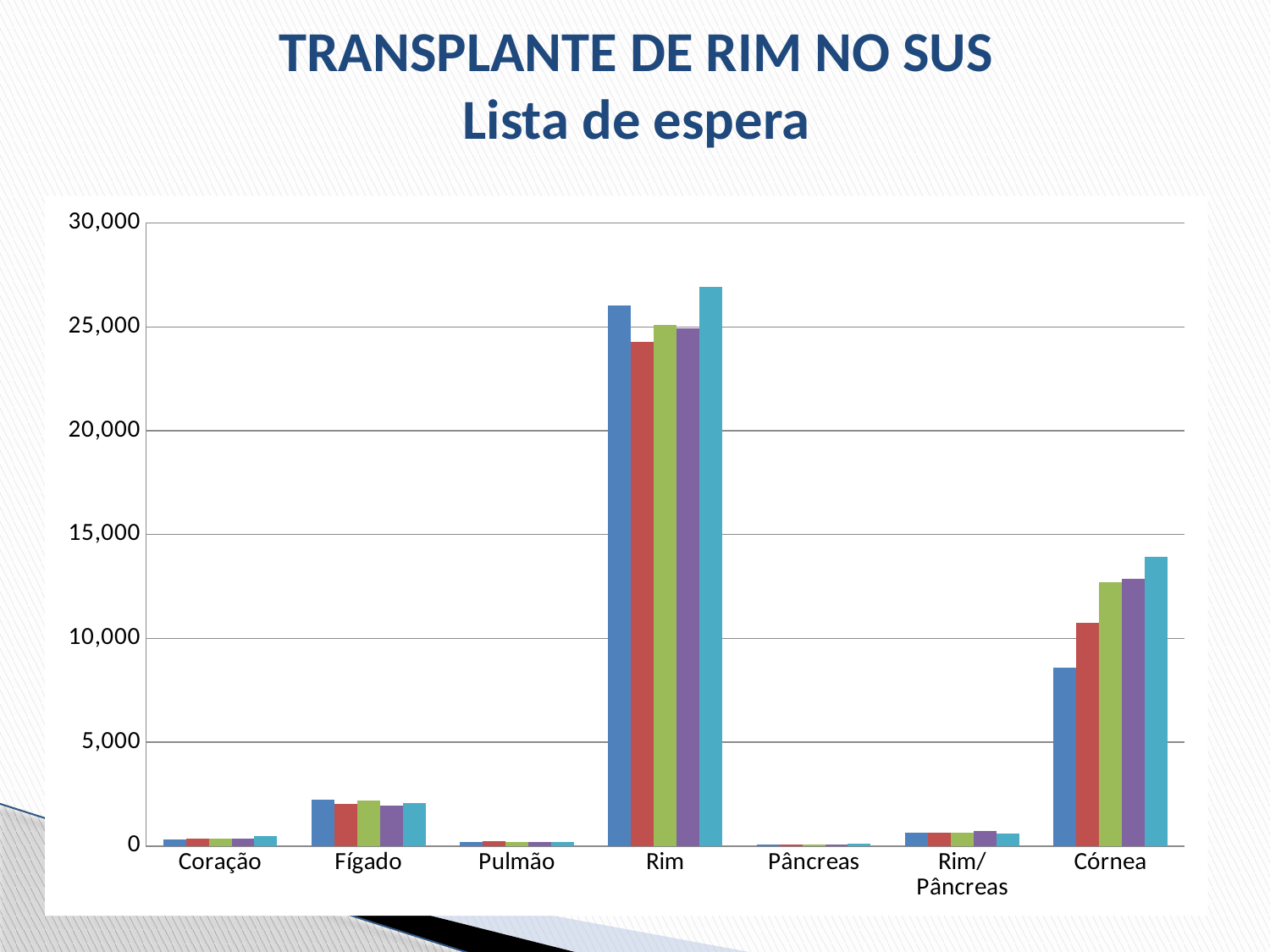
How many categories are shown on the x axis? 7 Which category has larger values, Rim or Córnea? Rim How many bars are plotted for each category? 5 What kind of chart is shown on the slide? bar chart Is the first (blue) bar for Córnea greater or less than 10,000? less Which category has the highest values? Rim What is the title of the slide? TRANSPLANTE DE RIM NO SUS Lista de espera Which category has the lowest values? Pâncreas Is the tallest bar for Córnea greater or less than 15,000? less Are the values for Rim greater or less than 20,000? greater Do the bars for Córnea rise or fall from left to right? rise